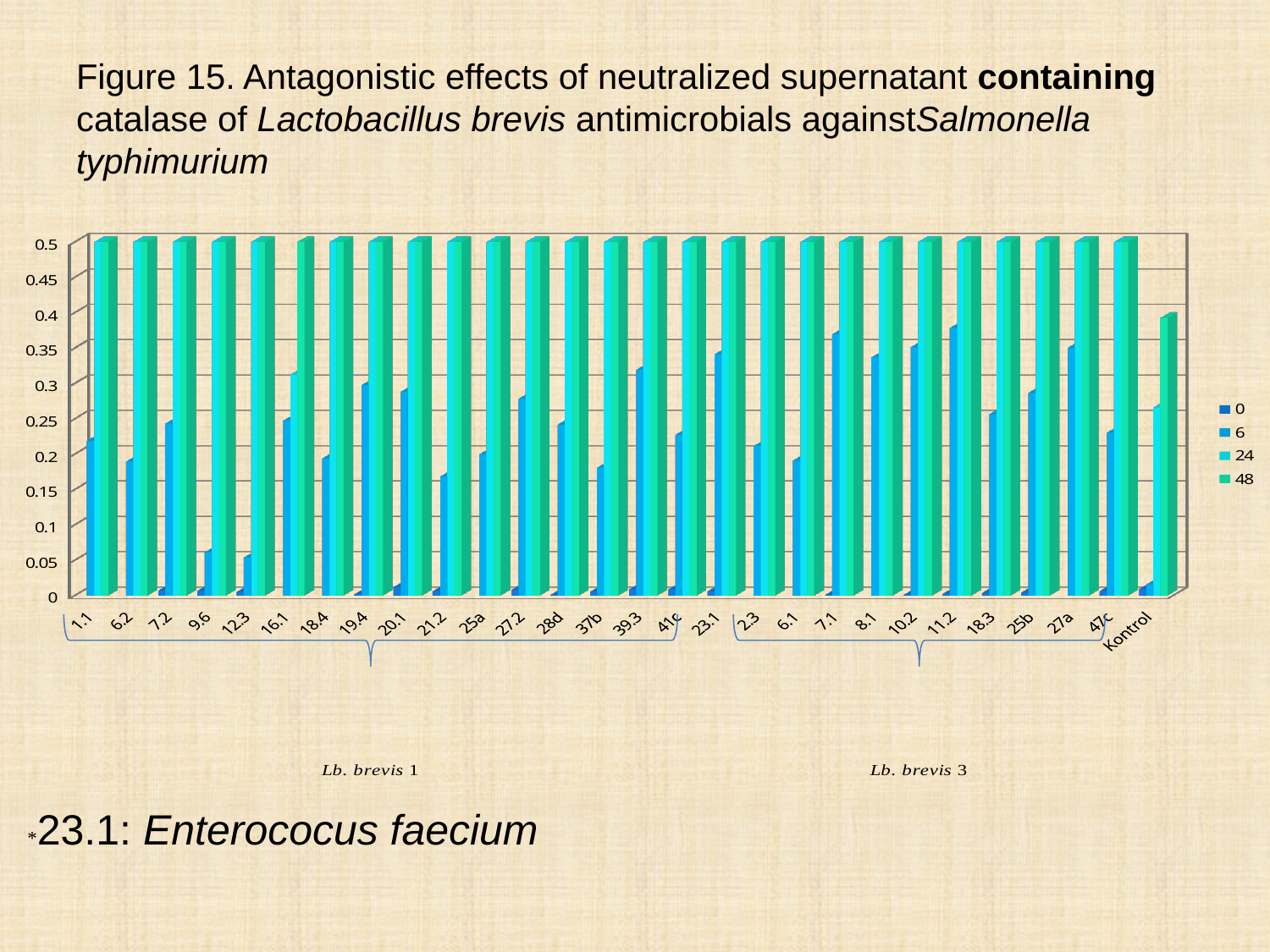
What are the series names listed in the chart legend? 0, 6, 24, 48 Is the value of the 6 series for category 11.2 greater or less than 0.35? greater How many series does the chart legend list? 4 Which is larger, the 6 series value for category 11.2 or for category 6.2? 11.2 Is the value of the 24 series for Kontrol greater or less than 0.3? less Is the value of the 48 series for Kontrol greater or less than 0.45? less What is the label of the last category on the x axis? Kontrol Which is larger, the 48 series value for category 1.1 or for Kontrol? 1.1 What kind of chart is shown on the slide? bar chart How many categories are shown along the x axis of the chart? 28